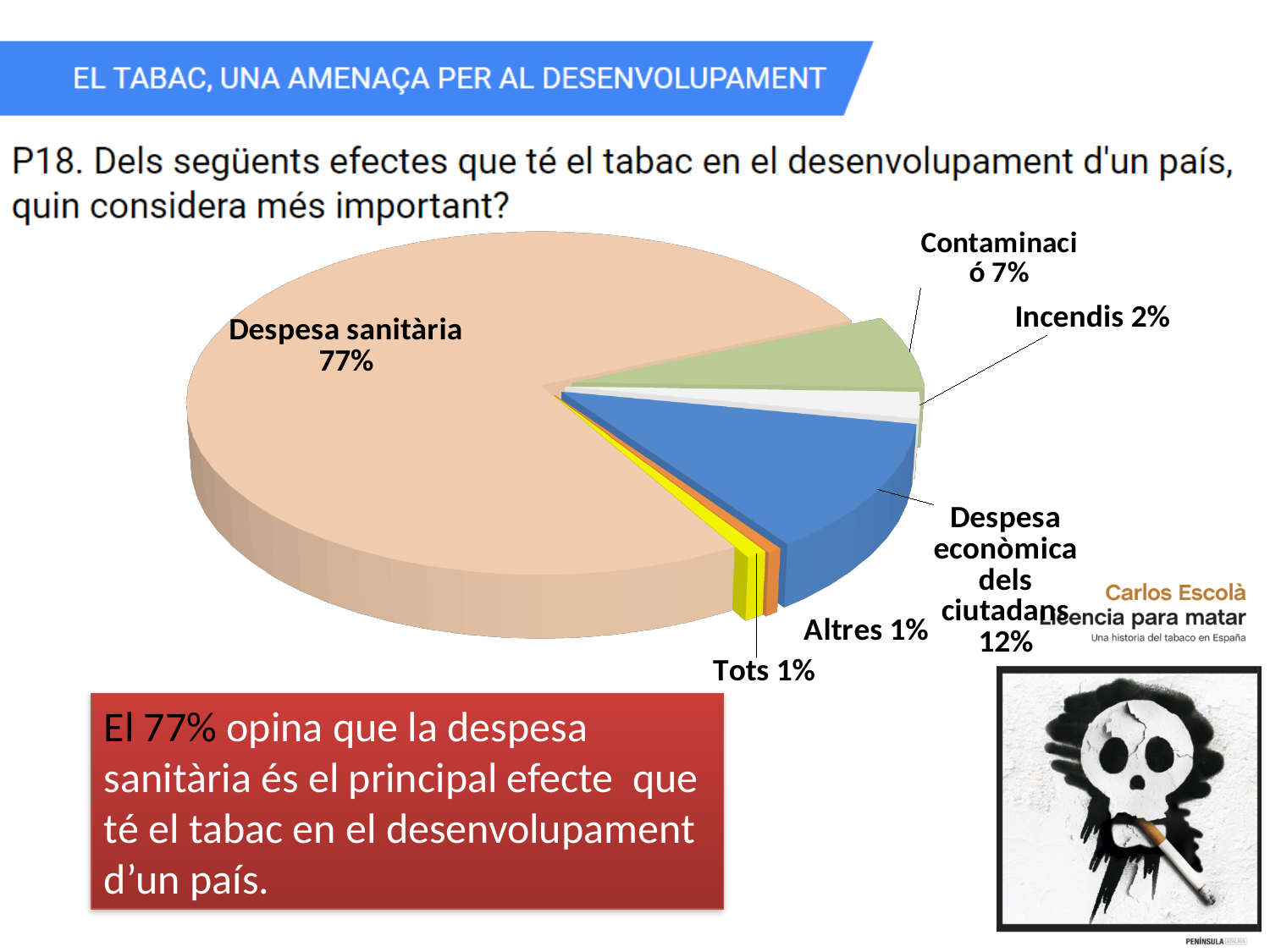
What percentage is shown for Altres? 1% Which is larger, the share for Contaminació or the share for Incendis? Contaminació How many slices does the pie chart have? 6 What is the difference in percentage points between Contaminació and Incendis? 5 Which category has the largest share of the pie? Despesa sanitària What percentage is shown for Despesa econòmica dels ciutadans? 12% Which two categories share the same percentage of 1%? Altres and Tots What percentage is shown for Contaminació? 7% What is the difference in percentage points between Despesa sanitària and Despesa econòmica dels ciutadans? 65 What percentage is shown for Incendis? 2% What percentage of respondents chose Despesa sanitària? 77% What kind of chart is shown on the slide? Pie chart